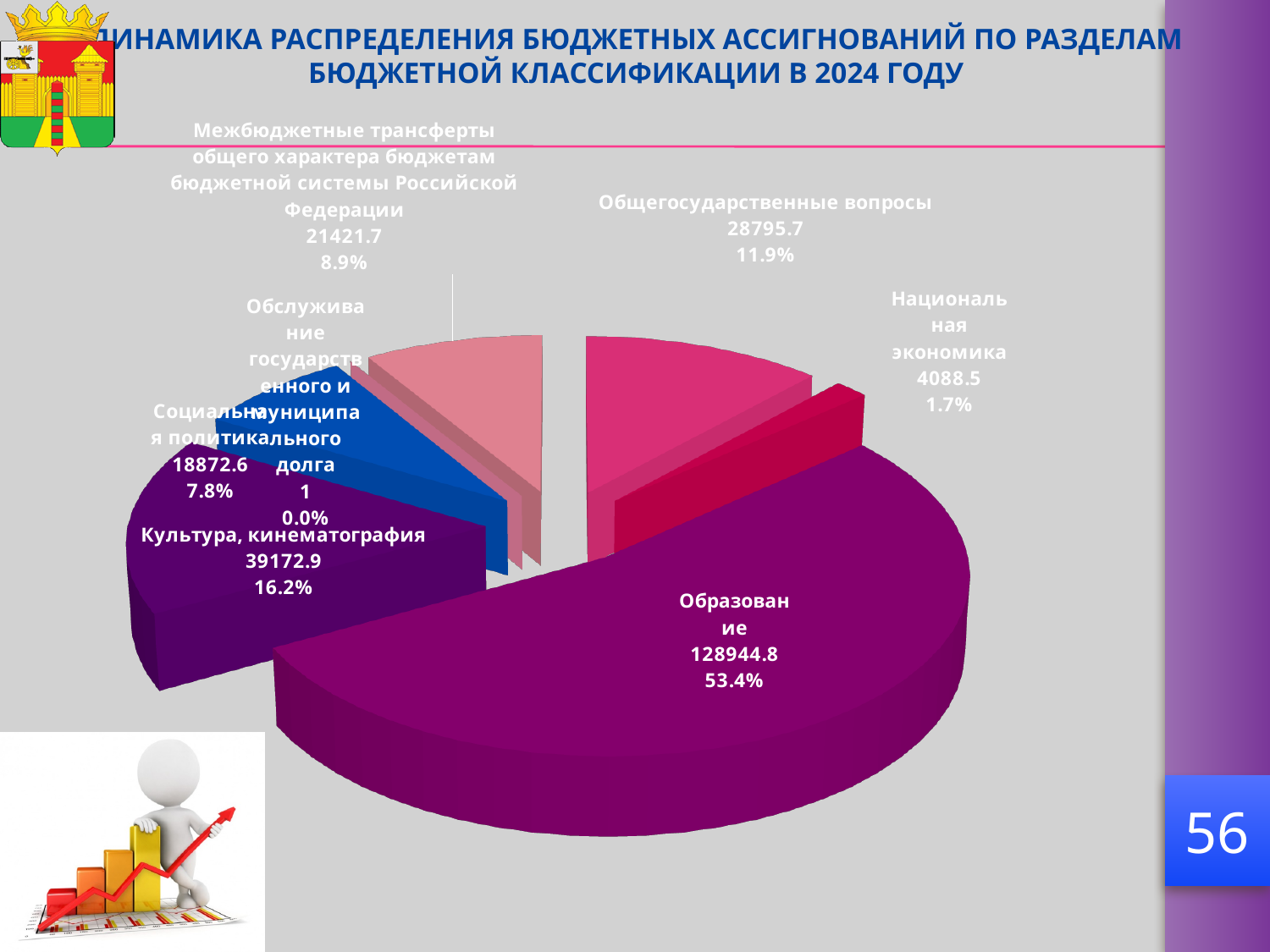
How many categories are shown in the pie chart? 7 What share of the pie does Образование represent? 53.4% What year does the chart title refer to? 2024 Which category has the smallest slice of the pie? Обслуживание государственного и муниципального долга What is the value shown for Образование? 128944.8 What is the value shown for Культура, кинематография? 39172.9 Which is larger: the value for Межбюджетные трансферты общего характера бюджетам бюджетной системы Российской Федерации or the value for Социальная политика? Межбюджетные трансферты общего характера бюджетам бюджетной системы Российской Федерации What percentage is shown for Общегосударственные вопросы? 11.9% What kind of chart is shown on the slide? Pie chart What is the difference between the values for Общегосударственные вопросы and Социальная политика? 9923.1 Which category has the largest slice of the pie? Образование What is the value shown for Национальная экономика? 4088.5